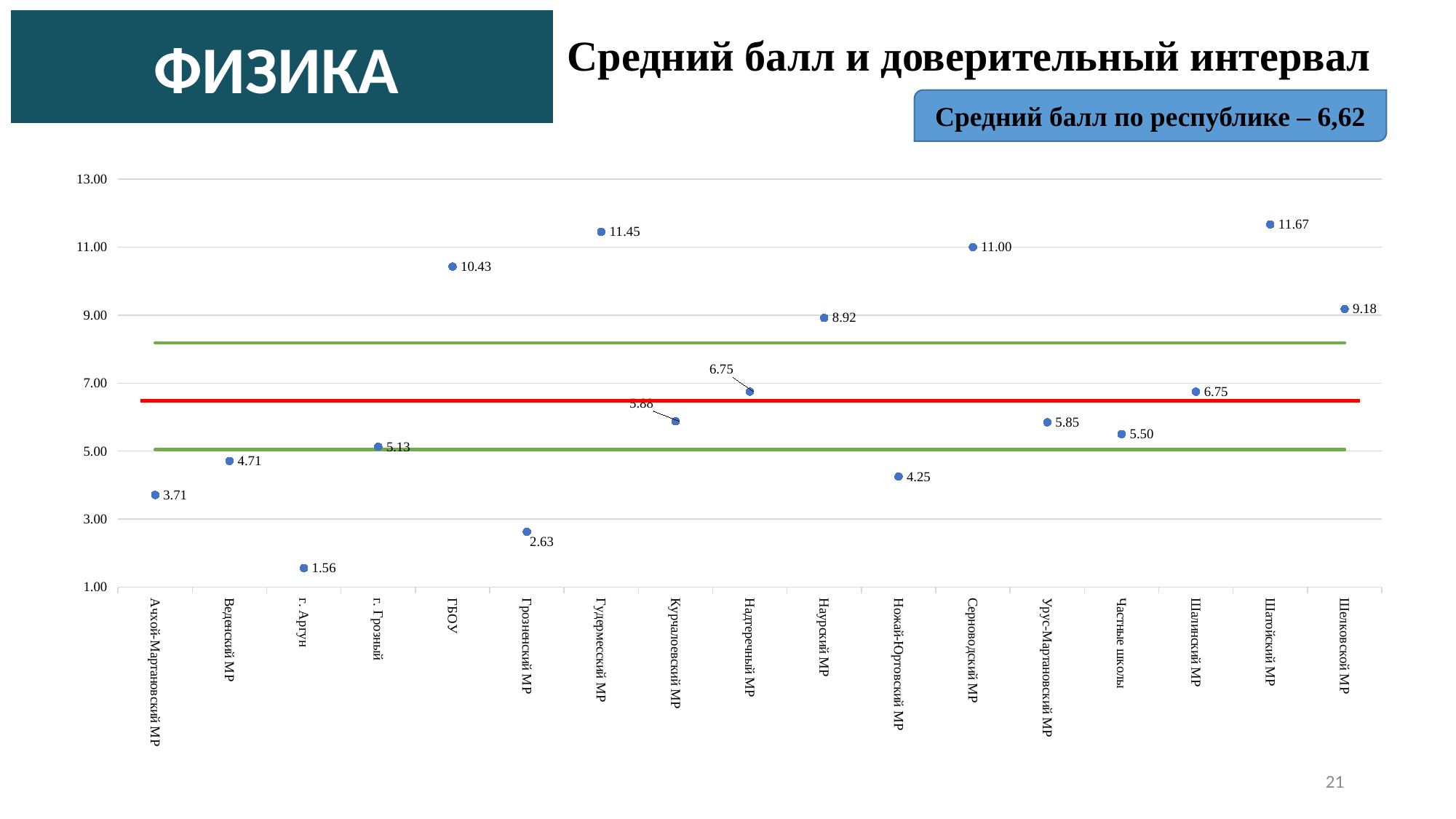
What is the value for Гудермесский МР? 11.45 What is the difference between the values for Шатойский МР and Серноводский МР? 0.67 How many categories are plotted on the x axis? 17 Which category has the lowest value? г. Аргун What is the value for Наурский МР? 8.92 What average score for the republic is stated on the slide? 6,62 What kind of chart is shown on the slide? scatter (dot) chart Which is larger, the value for ГБОУ or the value for Шелковской МР? ГБОУ Is the value for Ножай-Юртовский МР greater or less than 5.00? less Which category has the highest value? Шатойский МР What is the value for Частные школы? 5.50 What is the value for г. Аргун? 1.56